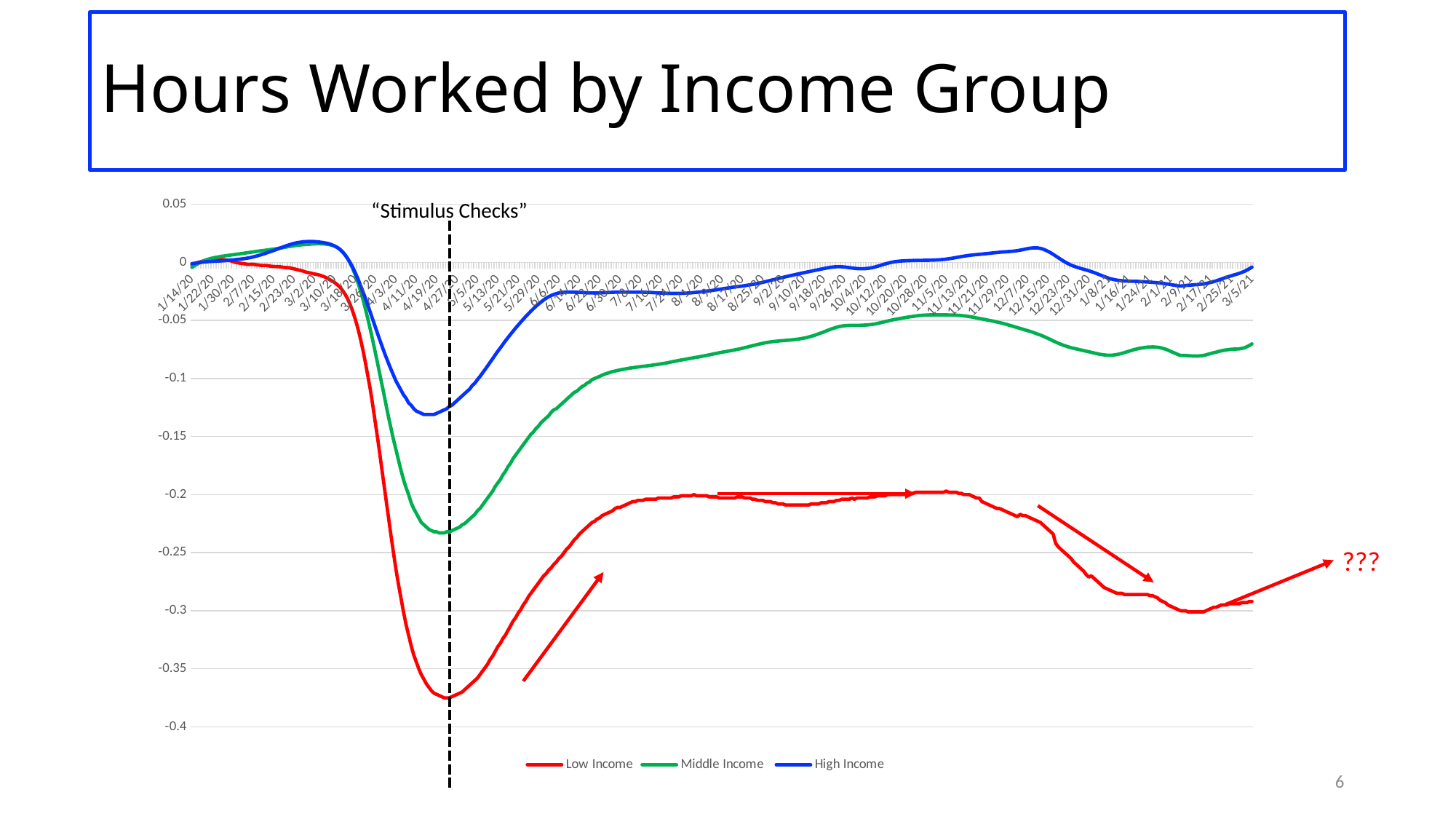
Is the lowest point of the Low Income line greater or less than -0.35? less Which series has the smallest dip below zero? High Income What kind of chart is shown on the slide? line chart What colour is the High Income line? blue What label is written next to the vertical dashed line on the chart? "Stimulus Checks" Is the Low Income value at 3/5/21 greater or less than -0.25? less Is the lowest point of the Middle Income line greater or less than -0.2? less Does the Low Income line rise or fall between 11/29/20 and 2/17/21? fall Which series reaches the lowest value on the chart? Low Income How many series does the legend list? 3 Around 10/28/20, which line is higher: Middle Income or Low Income? Middle Income